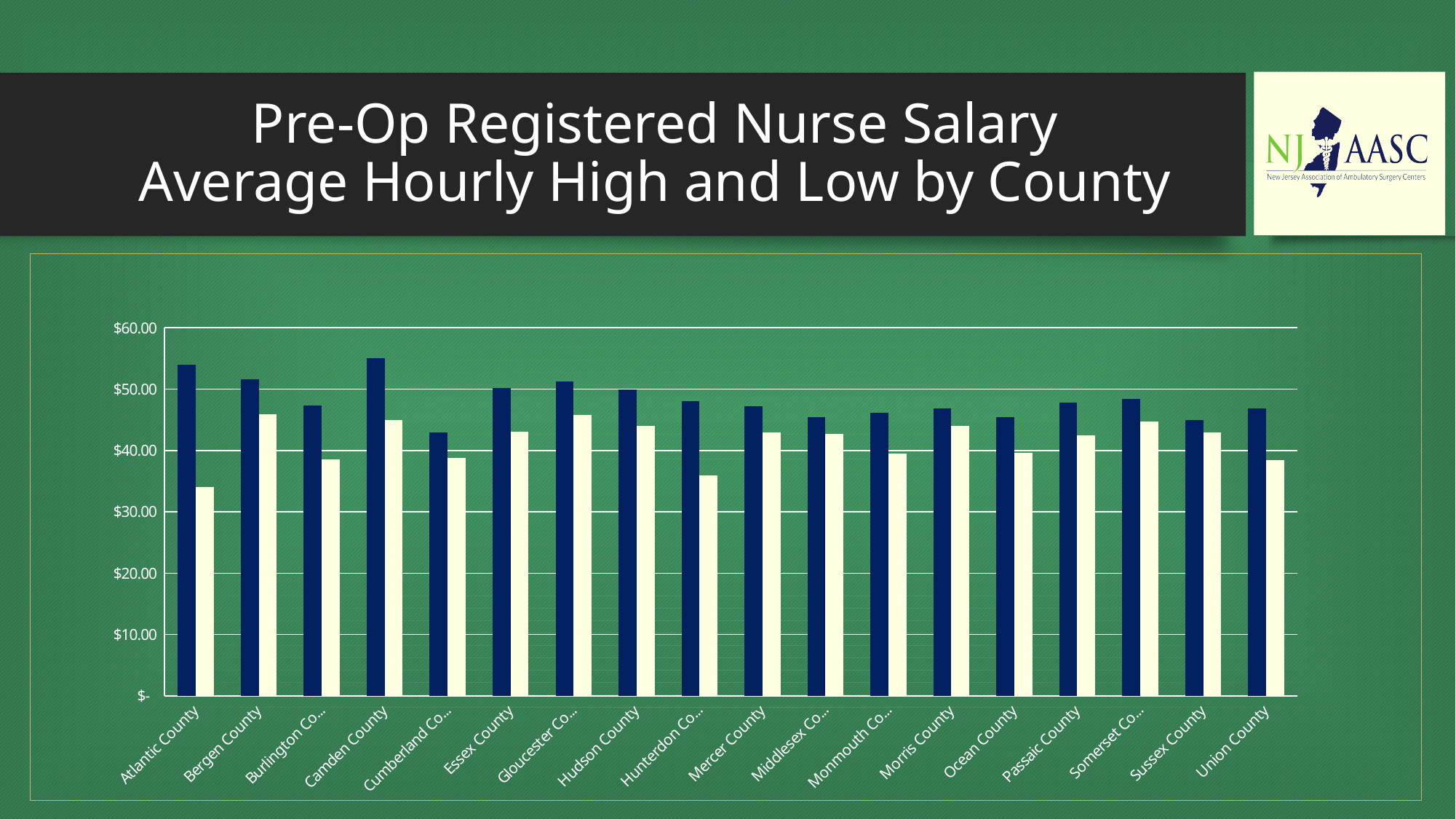
Which has the larger dark blue bar, Atlantic County or Cumberland County? Atlantic County Which has the larger light bar, Bergen County or Atlantic County? Bergen County What kind of chart is shown on the slide? Bar chart Is the value of the dark blue bar for Cumberland County greater or less than $50.00? less How many bars are plotted for each county in the chart? 2 Is the value of the light bar for Atlantic County greater or less than $40.00? less Is the value of the dark blue bar for Atlantic County greater or less than $50.00? greater How many counties are shown along the x axis of the chart? 18 What is the title of the chart on the slide? Pre-Op Registered Nurse Salary Average Hourly High and Low by County What is the highest value labelled on the vertical axis of the chart? $60.00